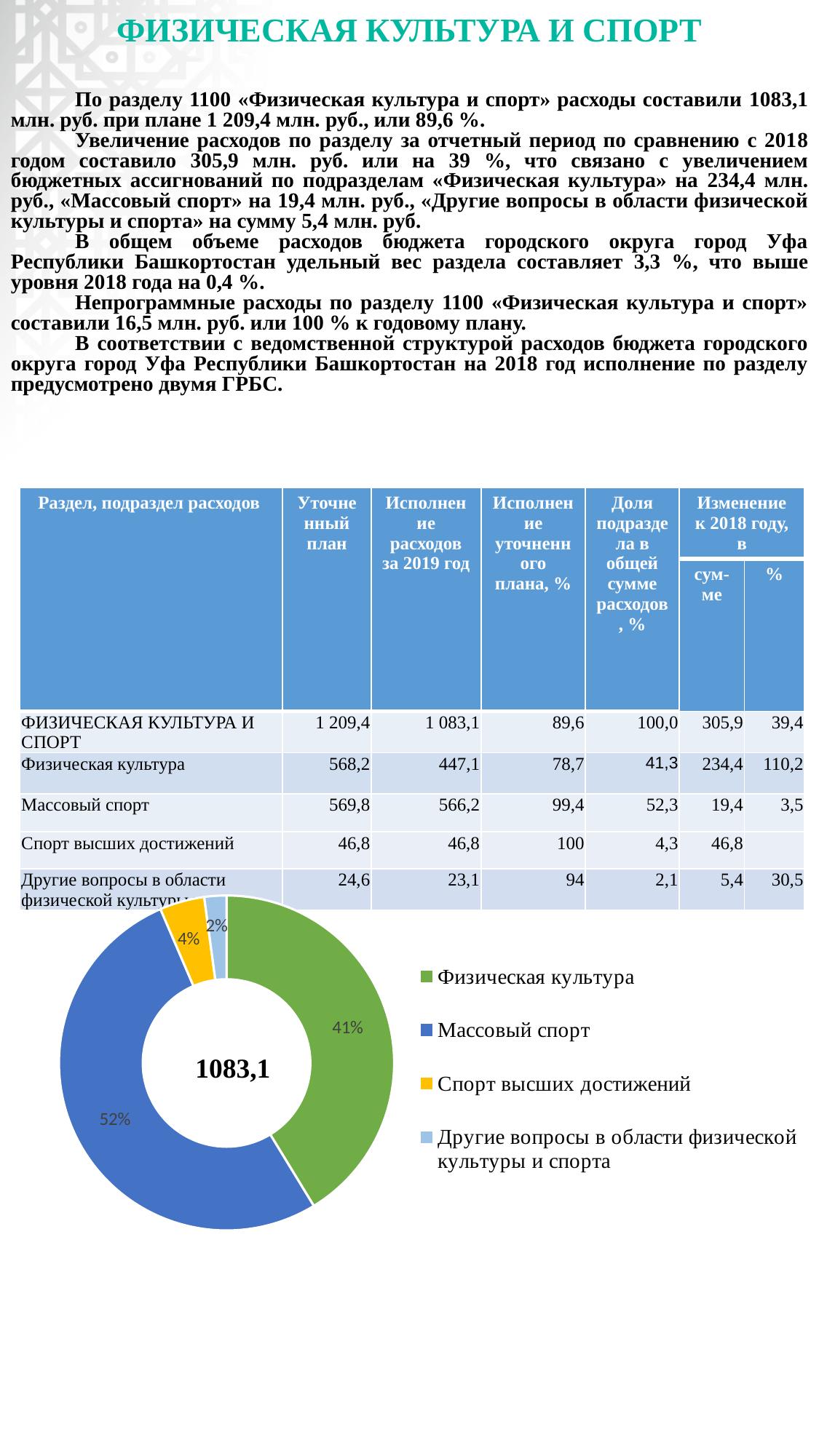
What share of the doughnut chart does «Физическая культура» take? 41% What share of the doughnut chart does «Спорт высших достижений» take? 4% What share of the doughnut chart does «Массовый спорт» take? 52% In the doughnut chart, which slice is larger: «Физическая культура» or «Массовый спорт»? Массовый спорт What colour is the «Спорт высших достижений» slice in the doughnut chart? Yellow Which category has the smallest slice in the doughnut chart? Другие вопросы в области физической культуры и спорта What kind of chart is shown at the bottom of the slide? Doughnut chart How many categories does the legend of the doughnut chart list? 4 What number is printed in the centre of the doughnut chart? 1083,1 Which category has the largest slice in the doughnut chart? Массовый спорт What is the difference in percentage points between the «Массовый спорт» and «Физическая культура» slices in the doughnut chart? 11